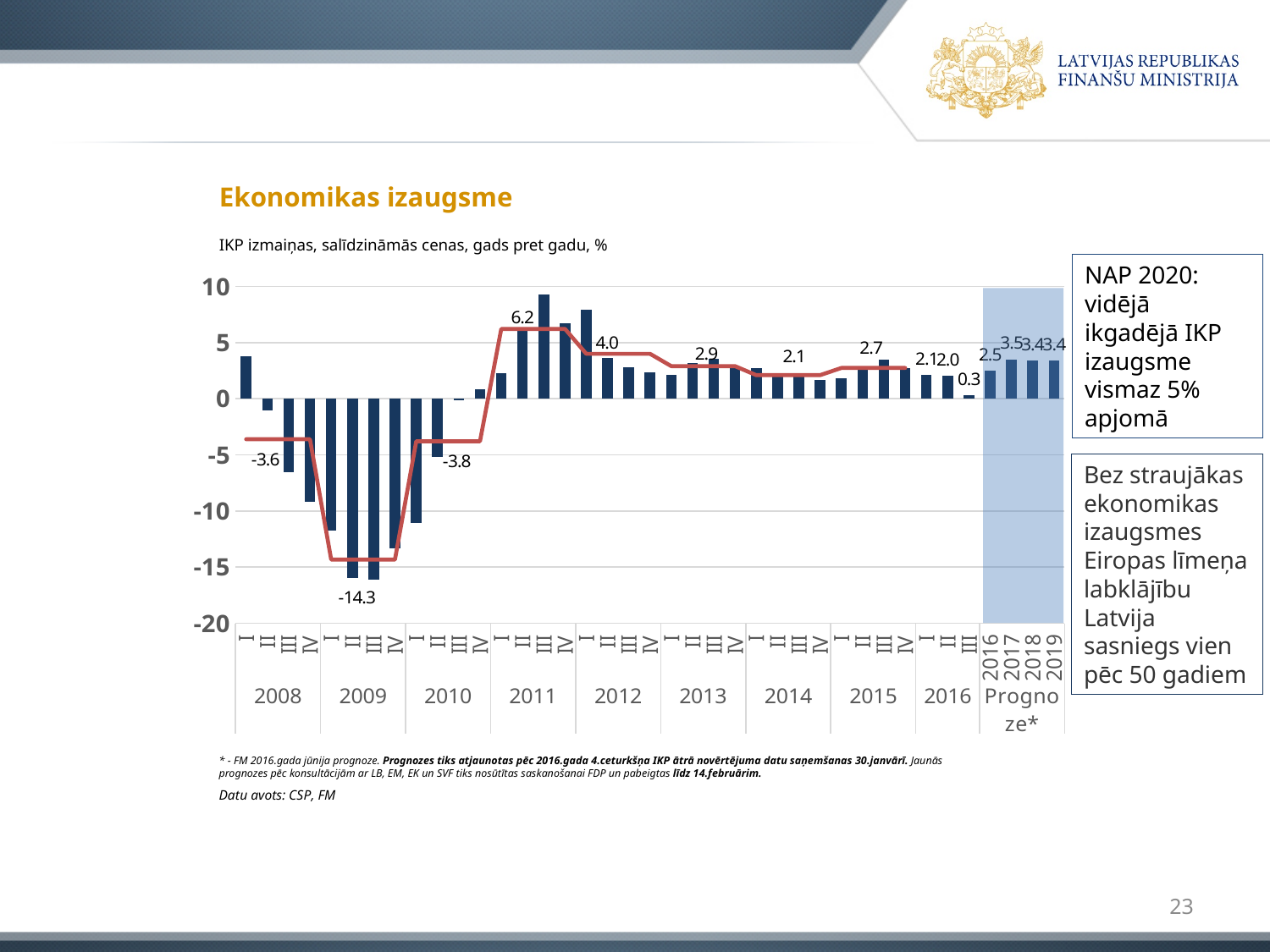
What is the annual GDP change value shown for 2009? -14.3 What is the forecast GDP growth value labelled for 2017? 3.5 Is the value of the bar for quarter III of 2011 greater or less than 5? greater What value is labelled for quarter III of 2016? 0.3 What kind of chart is used to show the quarterly GDP changes on this slide? bar chart Is the value of the bar for quarter II of 2009 greater or less than -10? less Which year has the highest annual GDP change value labelled on the chart? 2011 What is the difference between the annual values labelled for 2011 and 2012? 2.2 What is the annual GDP change value shown for 2011? 6.2 How many forecast years are shown in the shaded 'Prognoze*' area of the chart? 4 Which year has the lowest annual GDP change value labelled on the chart? 2009 Which year has the larger labelled annual value, 2013 or 2014? 2013